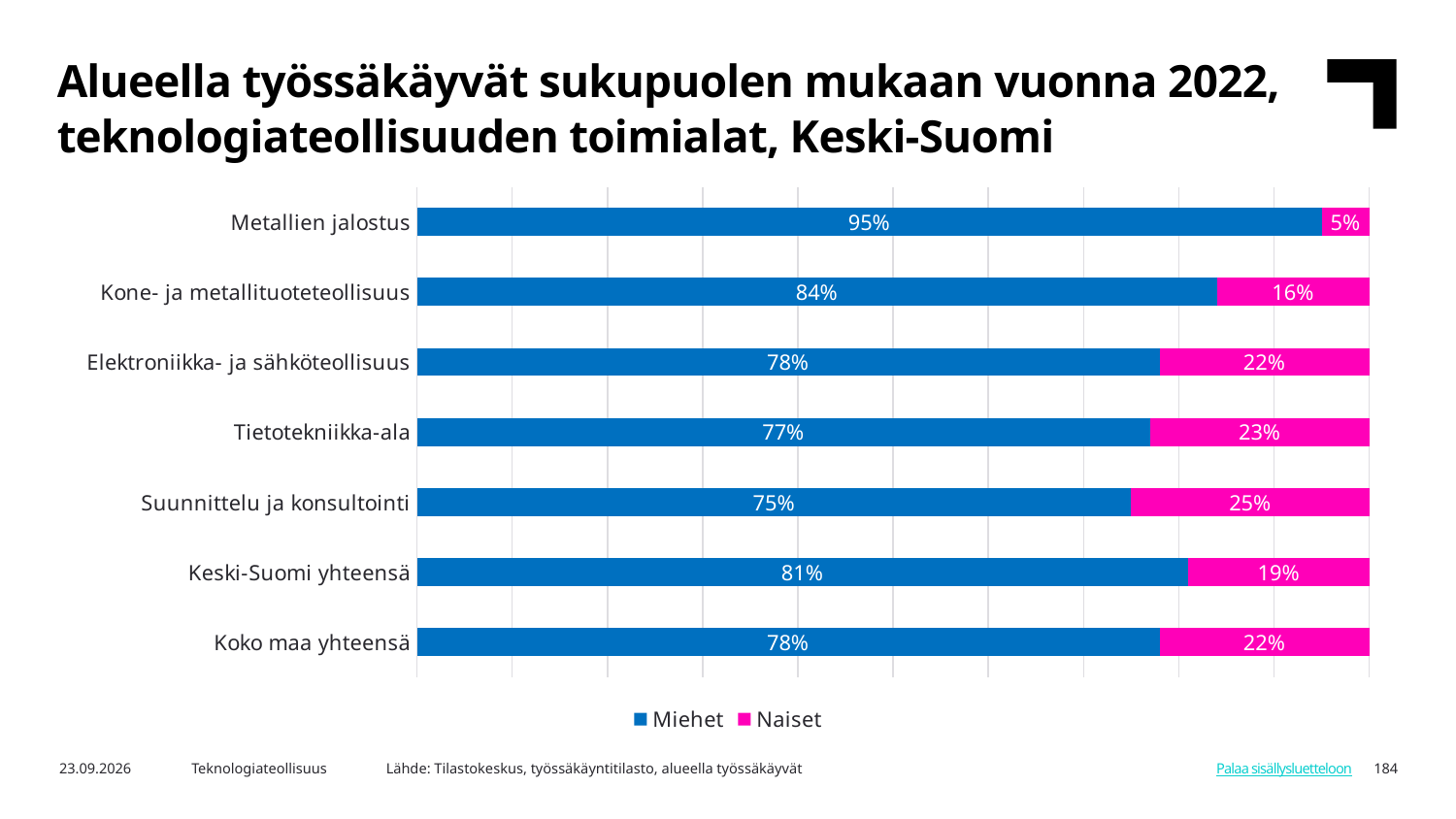
How many series does the legend list? 2 What is the Miehet share for Metallien jalostus? 95% What is the Miehet share for Keski-Suomi yhteensä? 81% Which is larger: the Naiset share for Tietotekniikka-ala or the Naiset share for Keski-Suomi yhteensä? Tietotekniikka-ala What is the Naiset share for Suunnittelu ja konsultointi? 25% Which category has the lowest Miehet share? Suunnittelu ja konsultointi What is the difference between the Miehet share for Metallien jalostus and the Miehet share for Tietotekniikka-ala? 18 percentage points What is the total of the stacked bar for Koko maa yhteensä? 100% What kind of chart is shown on the slide? Stacked bar chart What is the Naiset share for Kone- ja metallituoteteollisuus? 16% How many categories are shown on the chart? 7 Which category has the highest Naiset share? Suunnittelu ja konsultointi